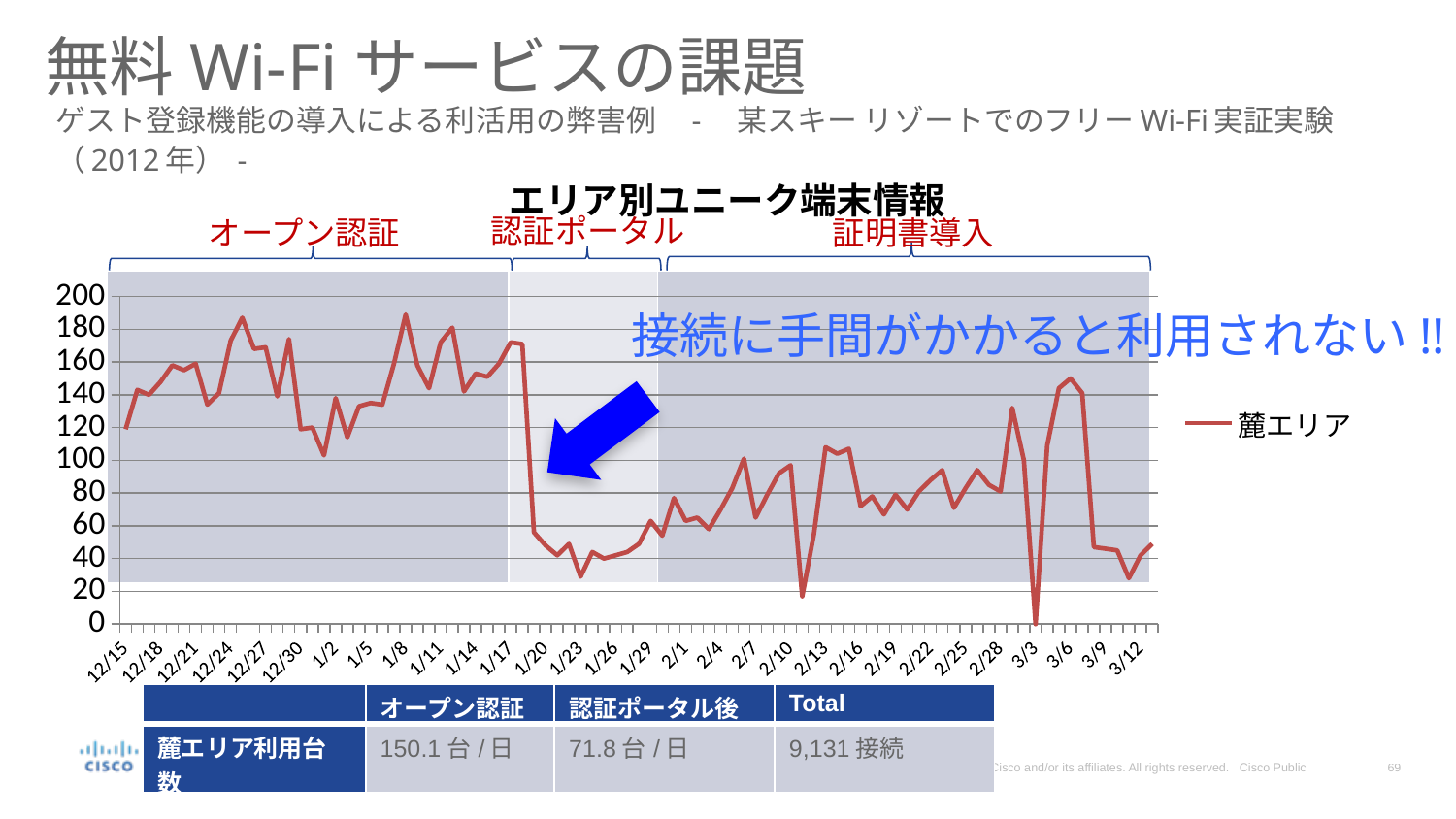
What is the highest value shown on the chart's y axis? 200 What is the name of the series shown in the chart legend? 麓エリア Do the values rise or fall between 1/17 and 1/20? fall What is the last date label on the chart's x axis? 3/12 Is the value for 1/23 greater or less than 60? less Which date has the larger value, 1/8 or 1/23? 1/8 What is the first date label on the chart's x axis? 12/15 What kind of chart is shown on the slide? line chart Is the value for 1/8 greater or less than 160? greater What is the title of the chart? エリア別ユニーク端末情報 Is the value for 2/10 greater or less than 40? greater How many series does the chart legend list? 1